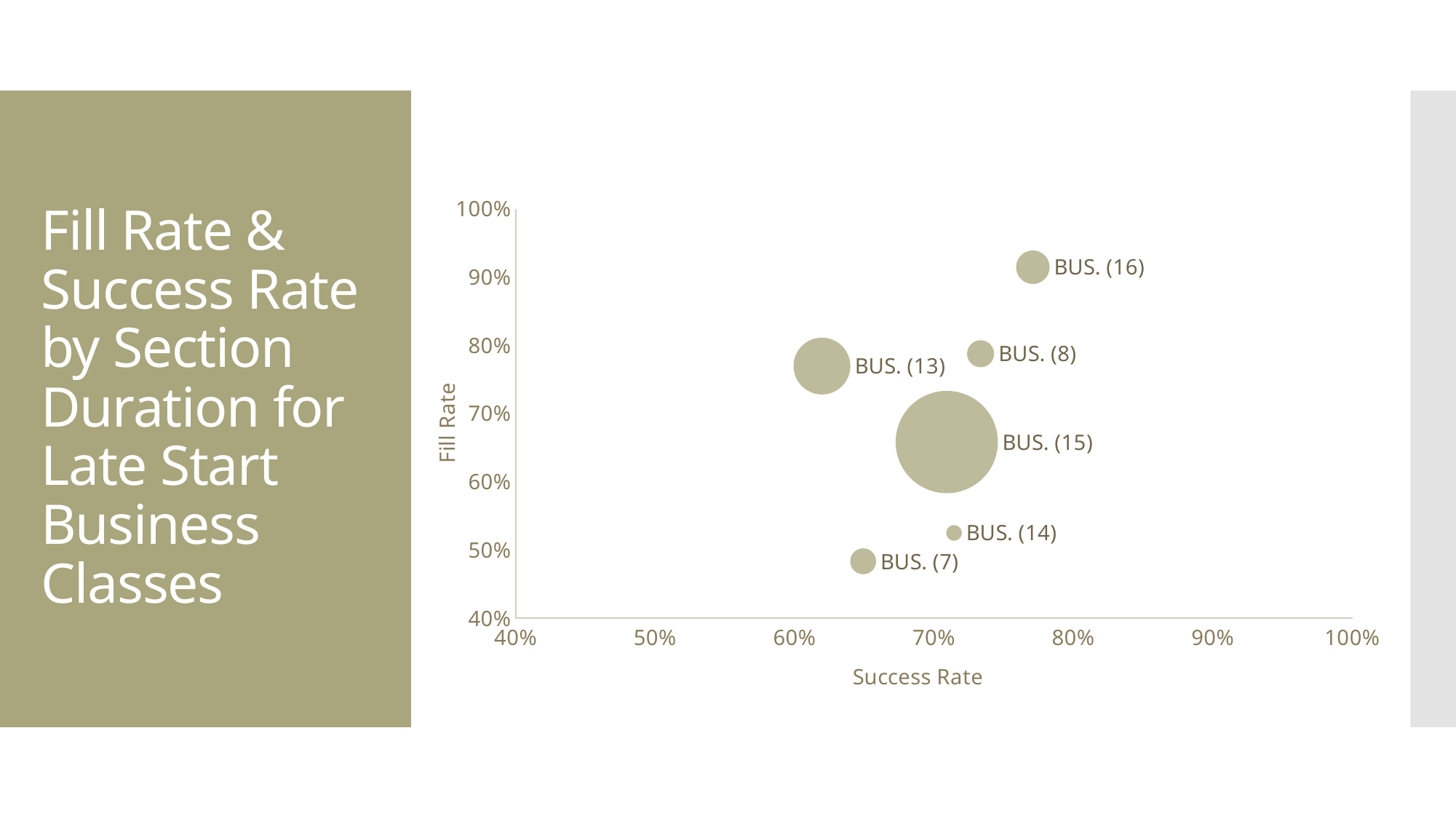
How many bubbles (sections) are plotted on the chart? 6 Which section is represented by the largest bubble? BUS. (15) Which section has the lowest Fill Rate? BUS. (7) Is the Fill Rate for BUS. (14) greater or less than 60%? less Is the Success Rate for BUS. (13) greater or less than 70%? less Which section has the highest Success Rate? BUS. (16) Which section has the highest Fill Rate? BUS. (16) What kind of chart is shown on the slide? bubble chart Which has the higher Fill Rate, BUS. (13) or BUS. (7)? BUS. (13) Is the Fill Rate for BUS. (16) greater or less than 80%? greater Which section has the lowest Success Rate? BUS. (13) What is the label of the horizontal axis? Success Rate